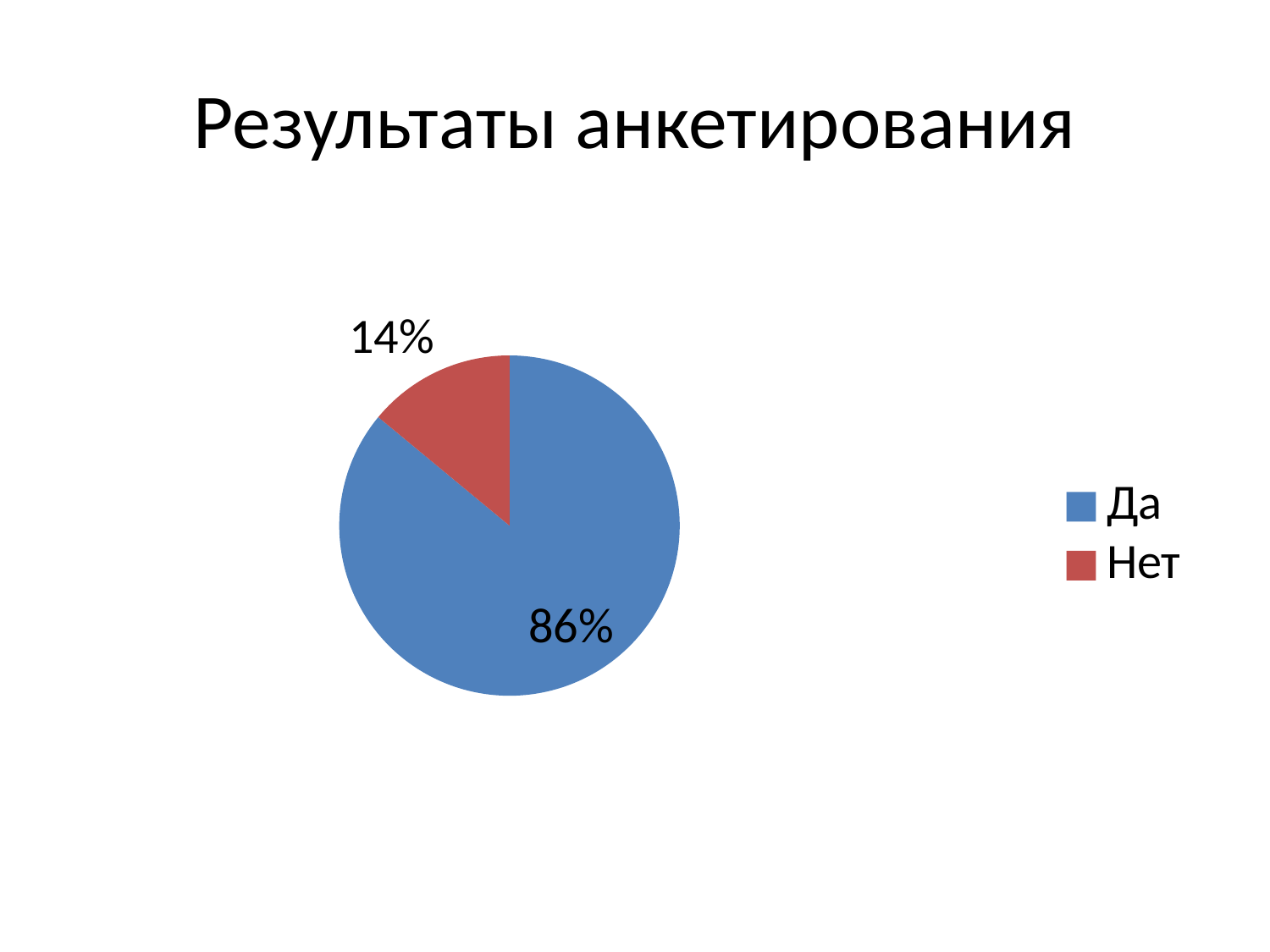
How many entries does the legend list? 2 What share of the pie does the "Да" slice represent? 86% What colour is the "Нет" slice? red What share of the pie does the "Нет" slice represent? 14% What is the title of the slide? Результаты анкетирования What kind of chart is shown on the slide? pie chart Which category has the largest slice of the pie? Да Which slice is larger, "Да" or "Нет"? Да What is the difference in percentage points between the "Да" and "Нет" slices? 72 Which category has the smallest slice of the pie? Нет How many categories does the pie chart show? 2